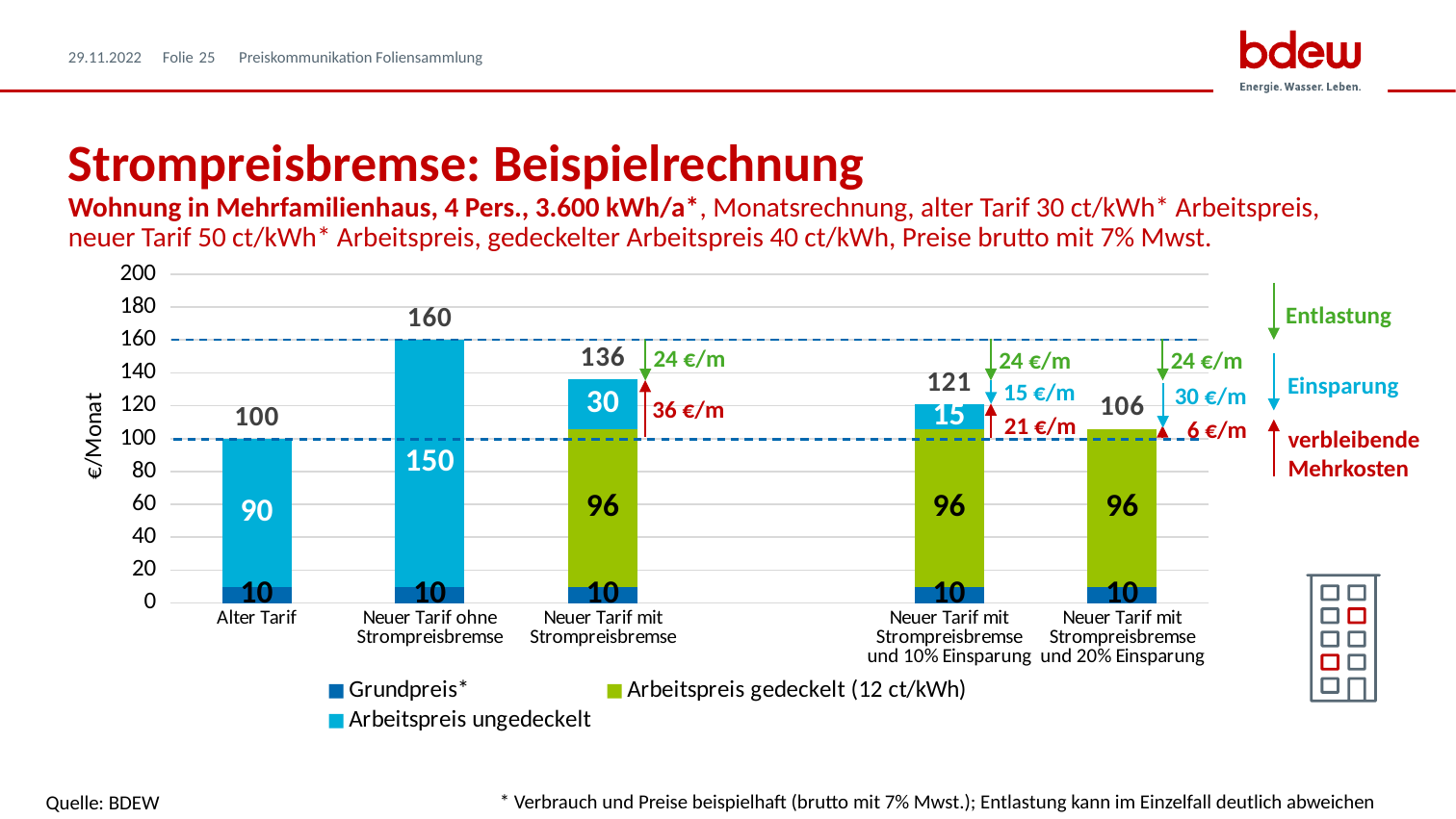
What is the "Arbeitspreis gedeckelt (12 ct/kWh)" value for "Neuer Tarif mit Strompreisbremse"? 96 What is the "Arbeitspreis ungedeckelt" value for "Neuer Tarif mit Strompreisbremse und 10% Einsparung"? 15 What is the total value shown above the bar for "Neuer Tarif ohne Strompreisbremse"? 160 How many categories are shown on the x axis? 5 Which category has the lowest total bar? Alter Tarif Which category has the highest total bar? Neuer Tarif ohne Strompreisbremse What is the label of the y axis? €/Monat What is the "Arbeitspreis ungedeckelt" value for "Alter Tarif"? 90 What kind of chart is shown on the slide? Stacked bar chart Which total is larger: "Neuer Tarif mit Strompreisbremse und 10% Einsparung" or "Neuer Tarif mit Strompreisbremse und 20% Einsparung"? Neuer Tarif mit Strompreisbremse und 10% Einsparung What is the difference between the totals for "Neuer Tarif ohne Strompreisbremse" and "Neuer Tarif mit Strompreisbremse"? 24 How many series does the legend list? 3